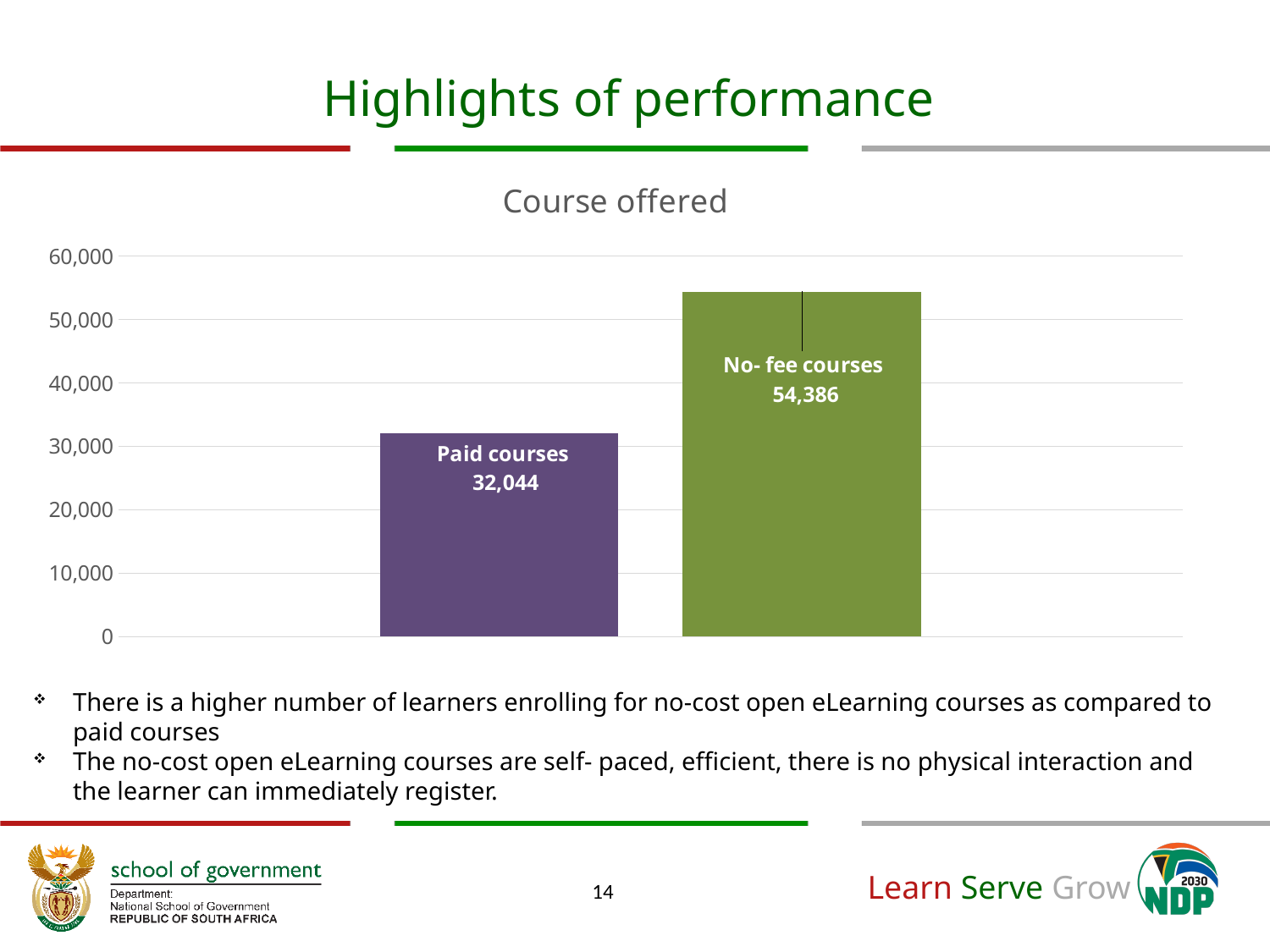
Is the value for Paid courses greater or less than 40,000? less What is the value for No- fee courses? 54,386 Which category has the lowest value? Paid courses How many categories are shown in the chart? 2 What is the value for Paid courses? 32,044 Which is larger, Paid courses or No- fee courses? No- fee courses What colour is the bar for No- fee courses? green Is the value for No- fee courses greater or less than 50,000? greater Which category has the highest value? No- fee courses What kind of chart is shown on the slide? bar chart What is the difference between the No- fee courses value and the Paid courses value? 22,342 What is the title of the chart? Course offered